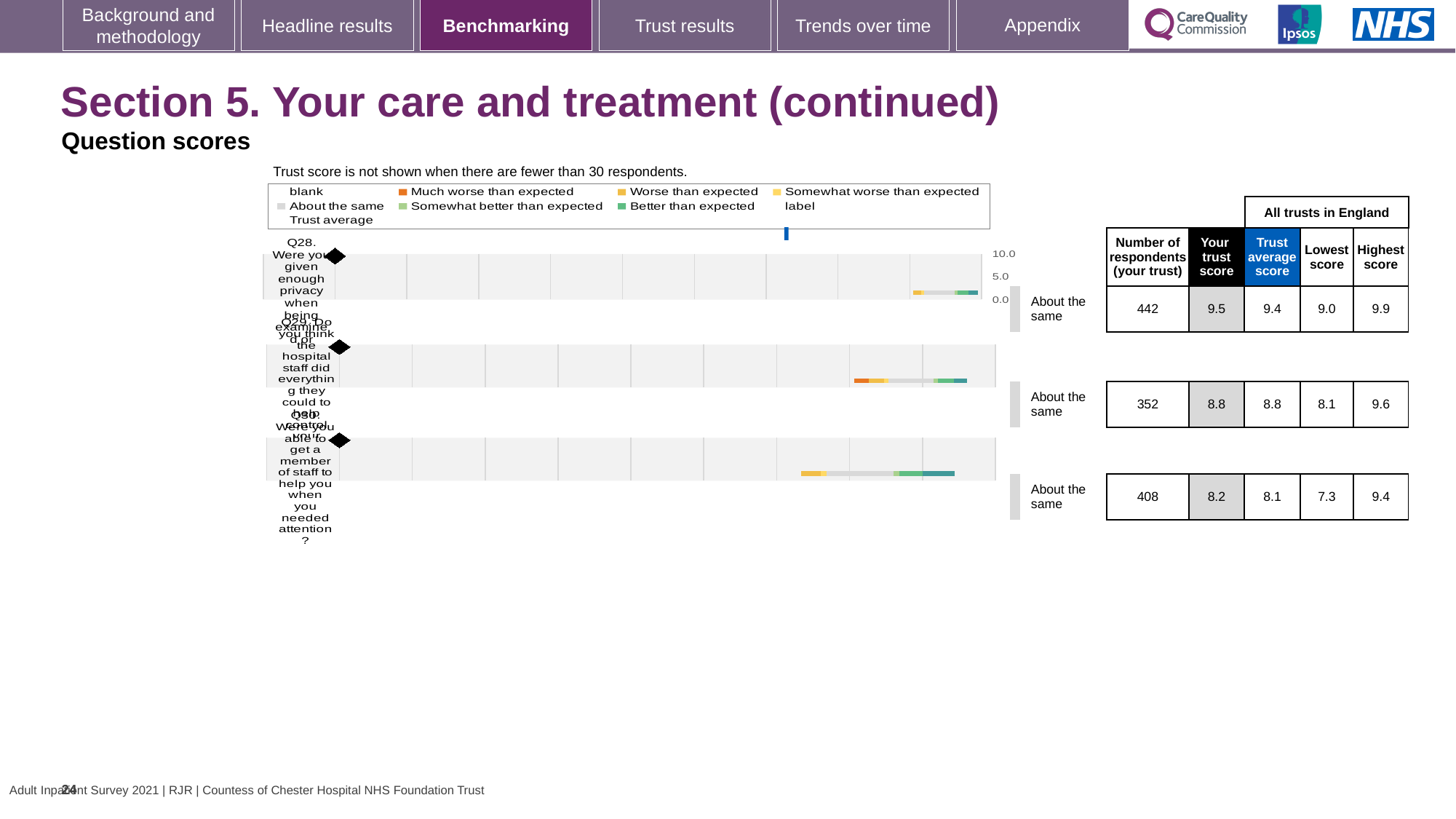
How many respondents from your trust answered Q29 (Do you think the hospital staff did everything they could to help control your pain)? 352 For Q28, what is the difference between the highest score and the lowest score across all trusts in England? 0.9 What benchmark category is shown for Q29? About the same What is the trust average score for Q30 (Were you able to get a member of staff to help you when you needed attention)? 8.1 What is the 'Your trust score' for Q28 (Were you given enough privacy when being examined or treated)? 9.5 For Q30, which is larger: your trust score or the trust average score? Your trust score Which question has the lowest 'Lowest score' among all trusts in England? Q30 What is the highest score across all trusts in England for Q30? 9.4 Which question has the highest 'Your trust score' on this slide? Q28 What kind of chart is used to show the question scores? Bar chart How many questions are charted on this slide? 3 Is the trust score for Q28 greater or less than 5.0 on the chart axis? greater